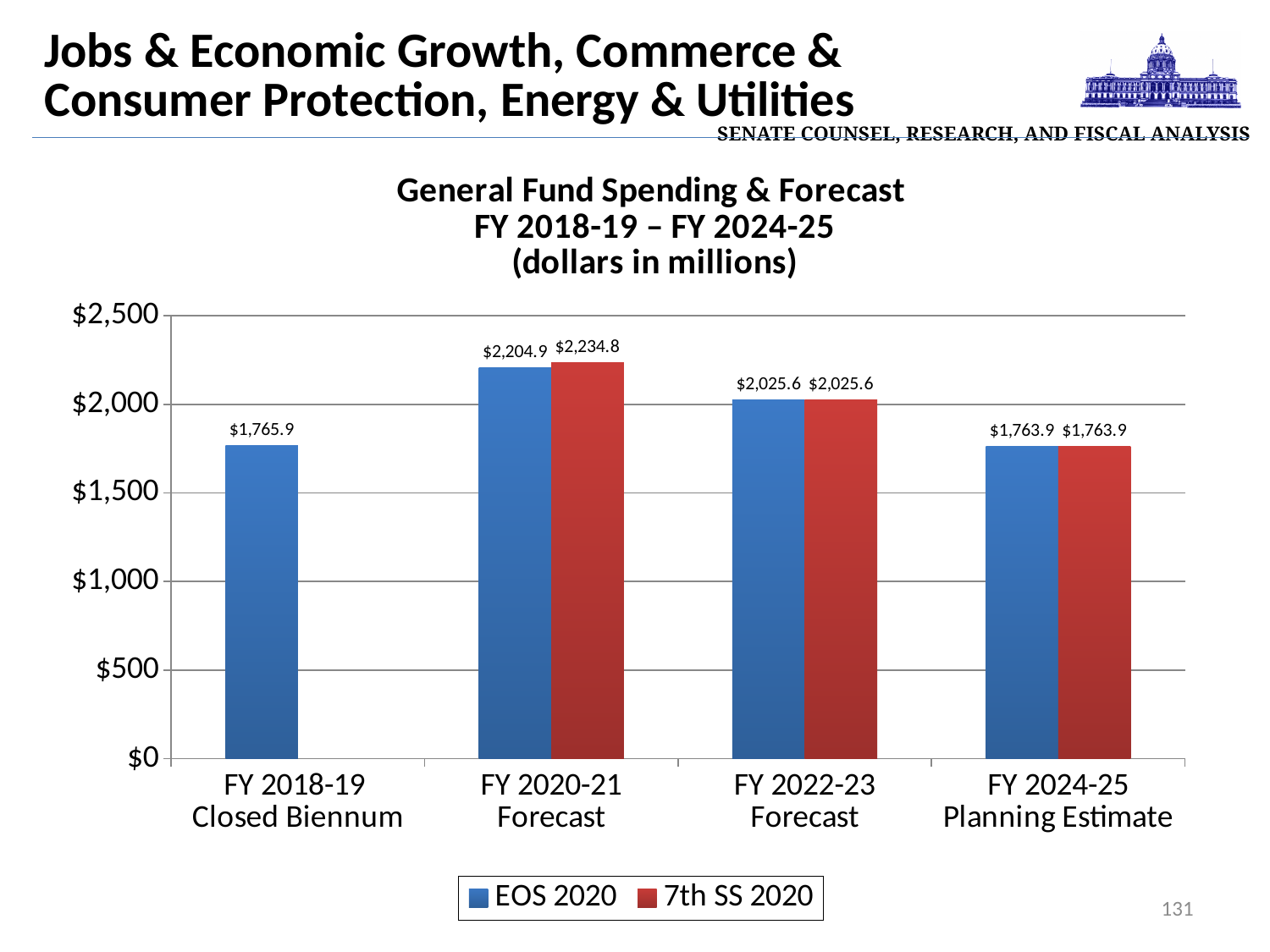
Which category has the highest EOS 2020 value? FY 2020-21 Forecast What is the EOS 2020 value for FY 2022-23 Forecast? $2,025.6 What is the 7th SS 2020 value for FY 2024-25 Planning Estimate? $1,763.9 What is the EOS 2020 value for FY 2018-19 Closed Biennum? $1,765.9 For FY 2020-21 Forecast, which series has the larger value, EOS 2020 or 7th SS 2020? 7th SS 2020 Which category has the lowest 7th SS 2020 value? FY 2024-25 Planning Estimate What kind of chart is shown on the slide? bar chart How many categories are shown on the x axis? 4 Is the EOS 2020 value for FY 2018-19 Closed Biennum greater or less than $2,000? less What is the difference between the 7th SS 2020 and EOS 2020 values for FY 2020-21 Forecast? $29.9 What is the 7th SS 2020 value for FY 2020-21 Forecast? $2,234.8 How many series does the legend list? 2